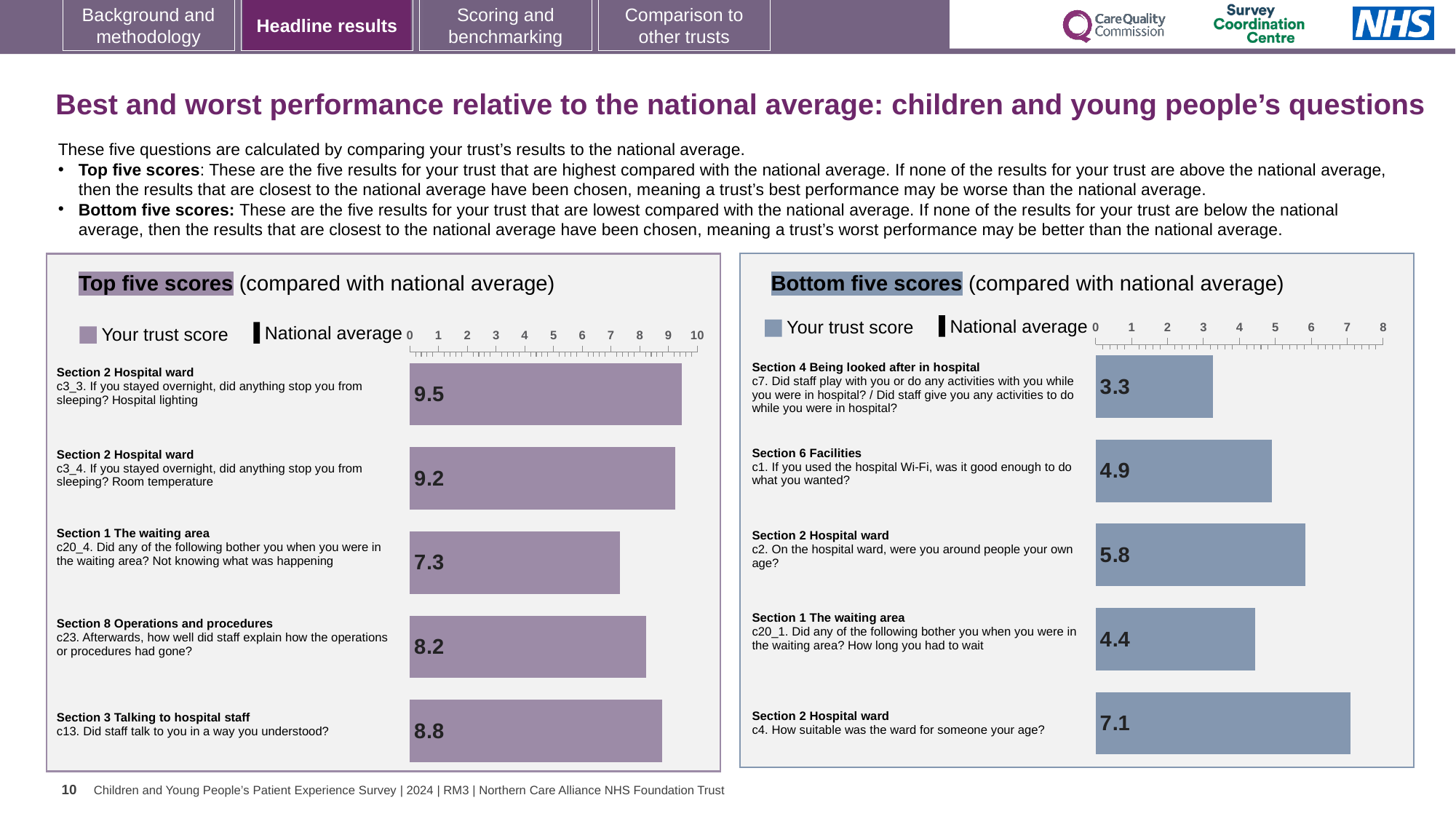
In the Bottom five scores chart, which question has the lowest trust score? c7. Did staff play with you or do any activities with you (3.3) In the Top five scores chart, which has the higher trust score: c23 (how well did staff explain how the operations had gone) or c13 (did staff talk to you in a way you understood)? c13 (8.8) In the Top five scores chart, what is the difference between the trust scores for c3_3 (hospital lighting) and c20_4 (not knowing what was happening)? 2.2 In the Bottom five scores chart, what is the trust score for c1 (was the hospital Wi-Fi good enough to do what you wanted)? 4.9 In the Top five scores chart, which question has the highest trust score? c3_3. Hospital lighting (9.5) What two entries does the legend of the Bottom five scores chart list? Your trust score; National average What type of chart is the Top five scores chart? Bar chart In the Top five scores chart, what is the trust score for c3_3 (did anything stop you from sleeping? Hospital lighting)? 9.5 In the Bottom five scores chart, which question has the highest trust score? c4. How suitable was the ward for someone your age? (7.1) In the Bottom five scores chart, what is the difference between the trust scores for c4 (how suitable was the ward) and c7 (did staff play with you)? 3.8 How many bars are plotted in the Bottom five scores chart? 5 In the Top five scores chart, which question has the lowest trust score? c20_4. Not knowing what was happening (7.3)